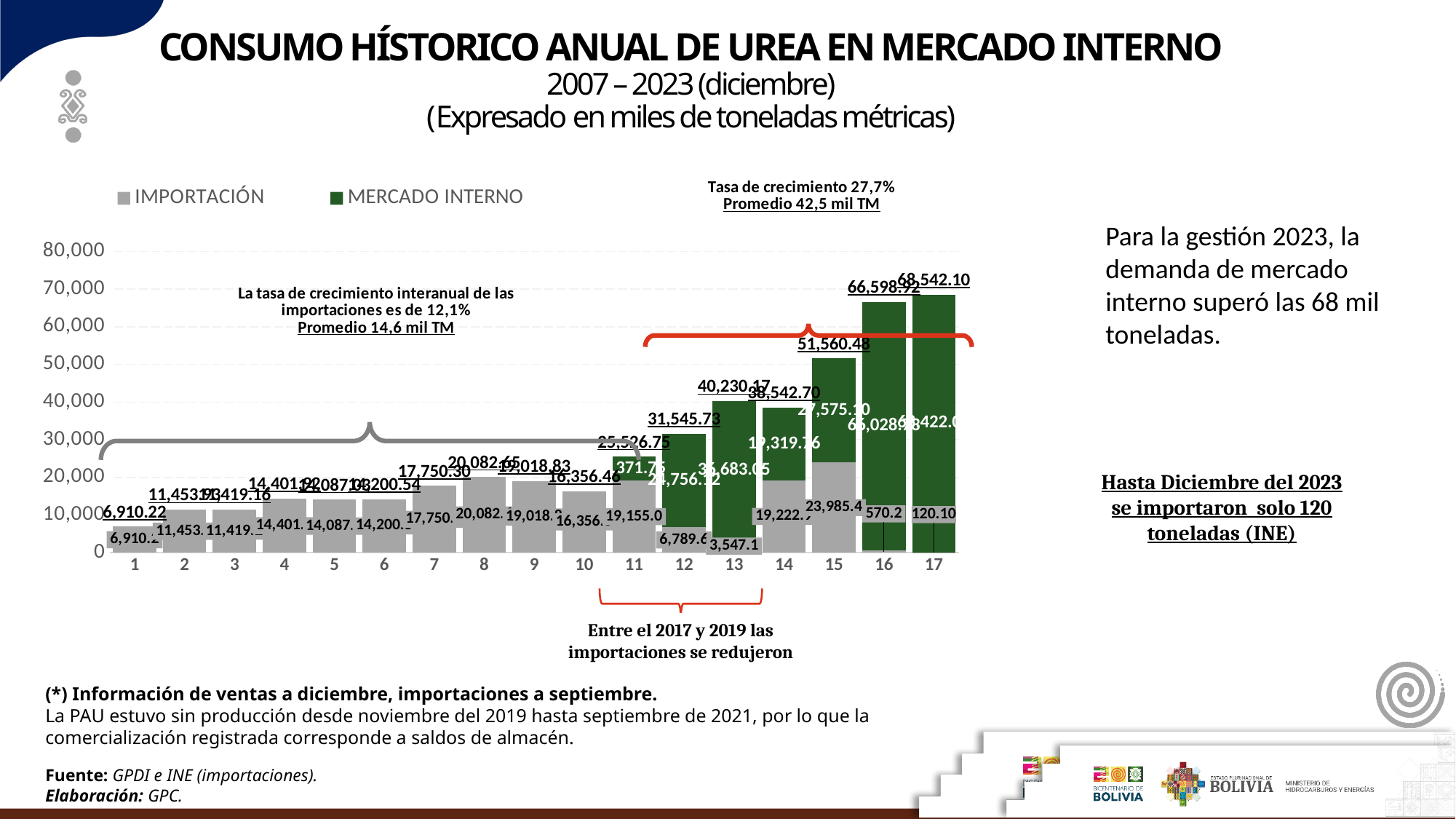
Is the total stacked bar for category 16 greater or less than 60,000? greater What is the IMPORTACIÓN value for category 17? 120.10 What is the MERCADO INTERNO value for category 13? 36,683.05 What are the two series named in the chart legend? IMPORTACIÓN and MERCADO INTERNO How many categories are shown along the x axis of the chart? 17 Which category has the lowest IMPORTACIÓN value? 17 How many series does the chart legend list? 2 What is the IMPORTACIÓN value for category 13? 3,547.1 What kind of chart is shown on the slide? bar chart Which category has the tallest stacked bar overall? 17 What is the IMPORTACIÓN value for category 16? 570.2 What is the IMPORTACIÓN value for category 12? 6,789.6